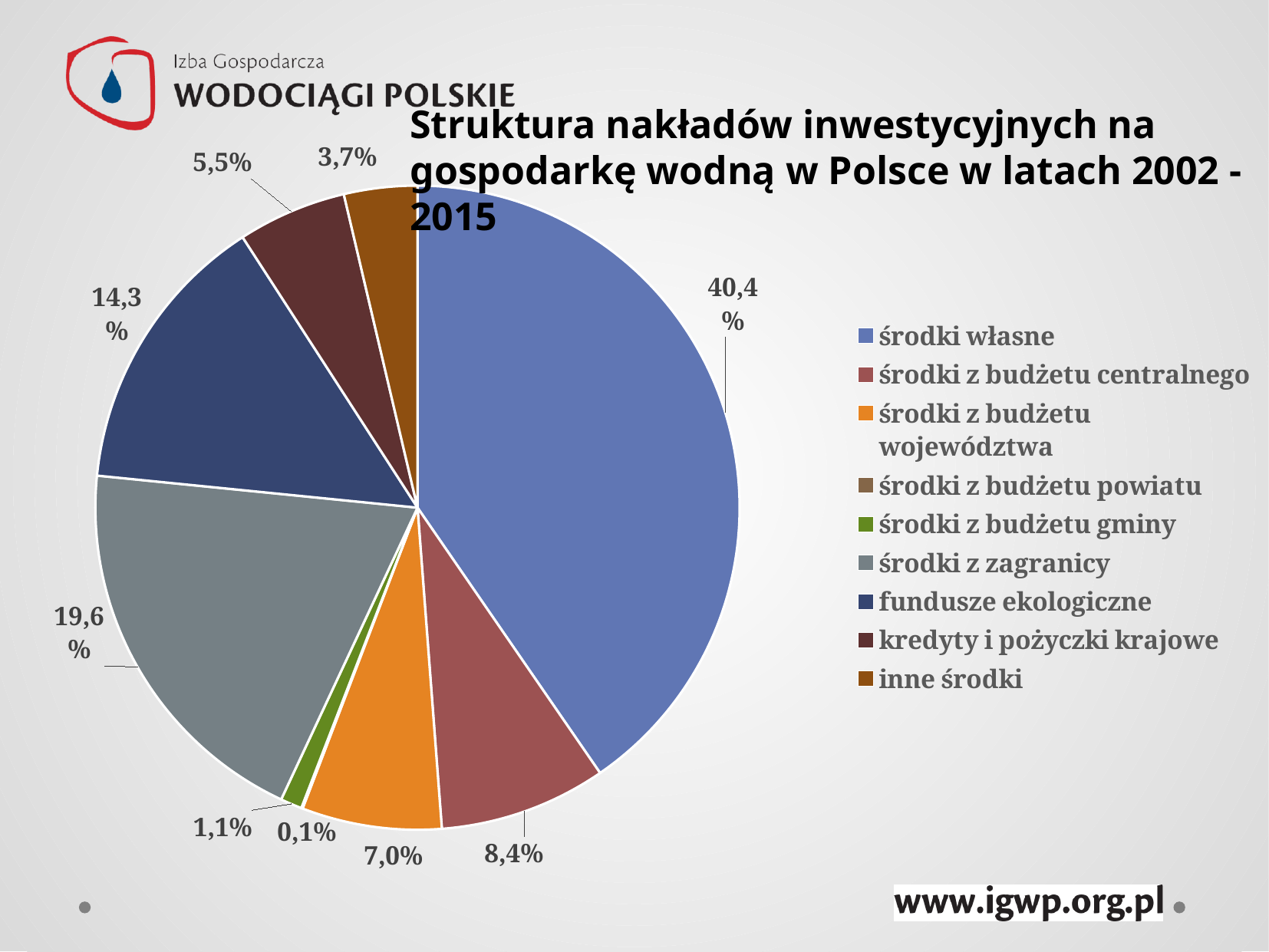
What is the difference between the shares of "środki z zagranicy" and "fundusze ekologiczne"? 5,3% Which category has the smallest share of the pie? środki z budżetu powiatu Which is larger: the share of "środki z budżetu województwa" or "kredyty i pożyczki krajowe"? środki z budżetu województwa How many categories does the legend list? 9 What is the title of the chart? Struktura nakładów inwestycyjnych na gospodarkę wodną w Polsce w latach 2002 - 2015 Which category has the largest share of the pie? środki własne What is the value shown for "inne środki"? 3,7% What is the value shown for "środki z budżetu centralnego"? 8,4% What is the value shown for "środki z zagranicy"? 19,6% What kind of chart is shown on the slide? pie chart What share of the pie does "środki własne" have? 40,4% What is the value shown for "fundusze ekologiczne"? 14,3%